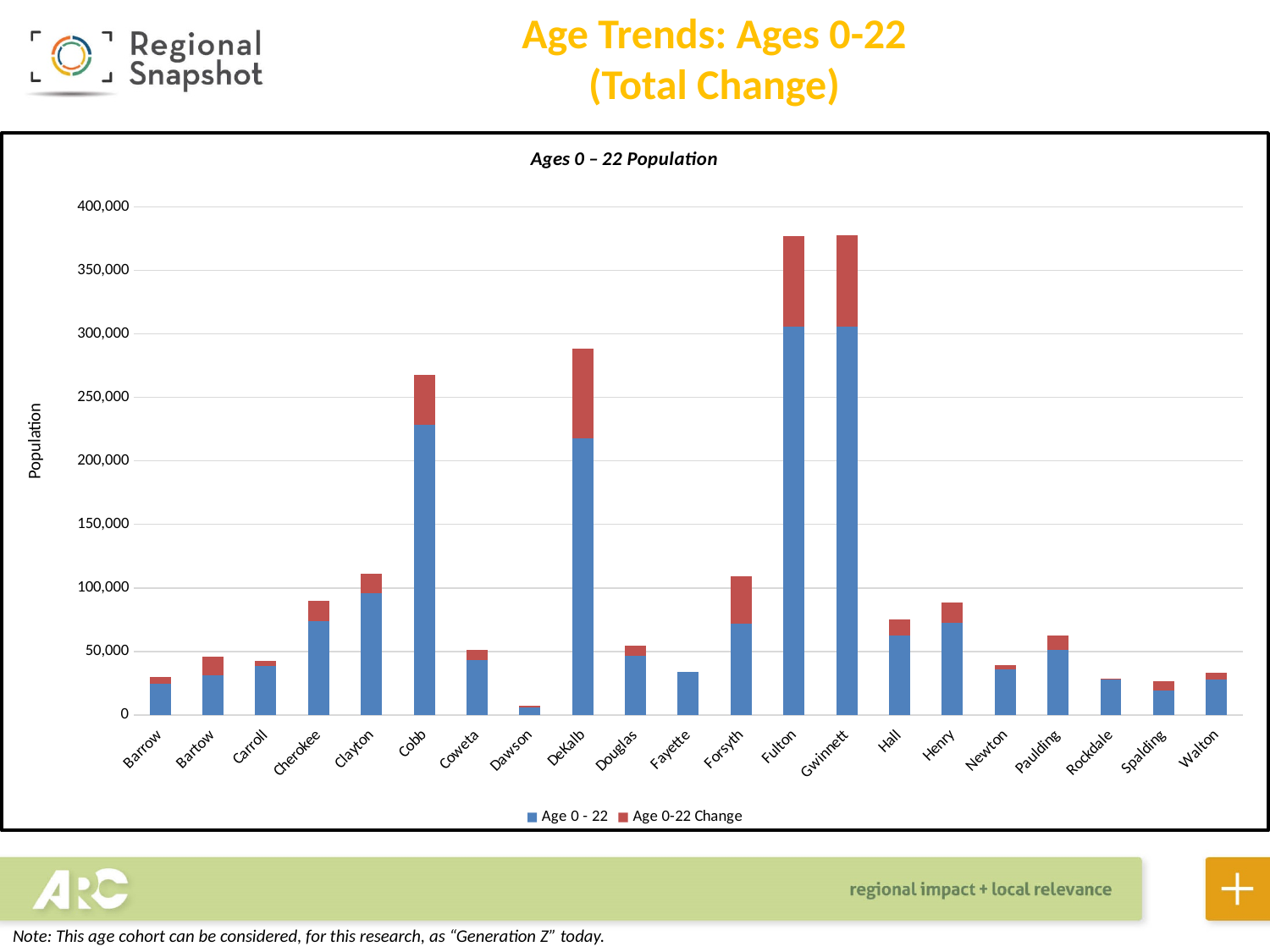
Which county has the lowest total bar? Dawson Which county has the larger total bar, Cherokee or Clayton? Clayton What kind of chart is shown on the slide? Stacked bar chart Is the total bar for Clayton greater or less than 100,000? greater What are the two legend entries of the chart? Age 0 - 22 and Age 0-22 Change Is the total bar for Cobb greater or less than 250,000? greater How many counties are shown on the x axis? 21 How many series does the legend list? 2 Which county has the larger total bar, Cobb or DeKalb? DeKalb Is the total bar for Fayette greater or less than 50,000? less What is the title of the chart? Ages 0 – 22 Population